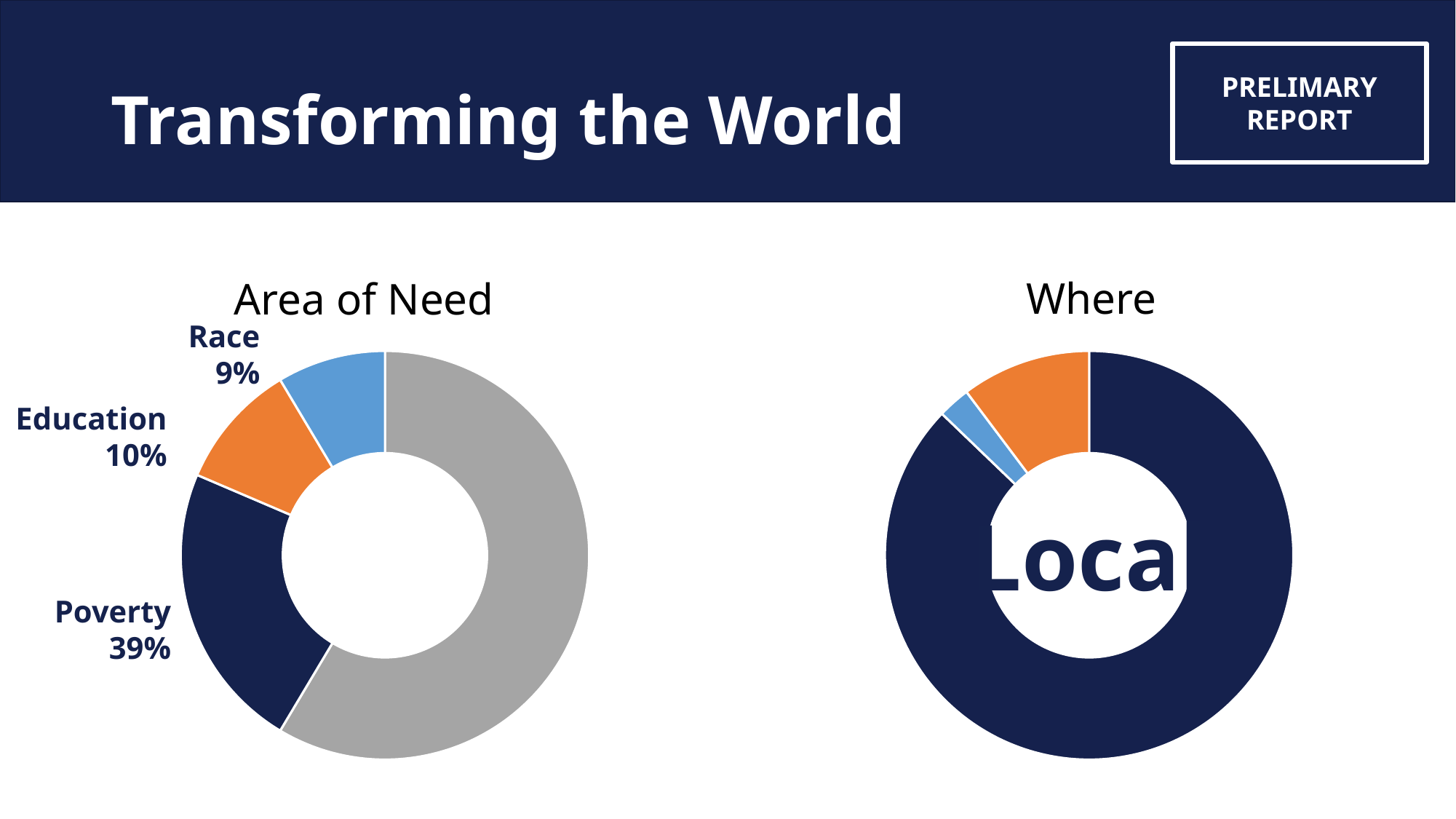
In the Area of Need chart, what percentage is shown for Education? 10% In the Area of Need chart, what percentage is shown for Poverty? 39% In the Area of Need chart, which of the labelled categories (Poverty, Education, Race) has the smallest share? Race In the Area of Need chart, how many slices does the doughnut have? 4 What is the title of the chart on the right side of the slide? Where In the Area of Need chart, how many percentage points larger is Education than Race? 1 percentage point In the Area of Need chart, what is the combined share of Poverty, Education and Race? 58% In the Area of Need chart, which is larger, Poverty or Race? Poverty In the Area of Need chart, how many percentage points larger is Poverty than Education? 29 percentage points In the Area of Need chart, what percentage is shown for Race? 9% What kind of chart is the Area of Need chart? Doughnut chart In the Area of Need chart, which of the labelled categories (Poverty, Education, Race) has the largest share? Poverty